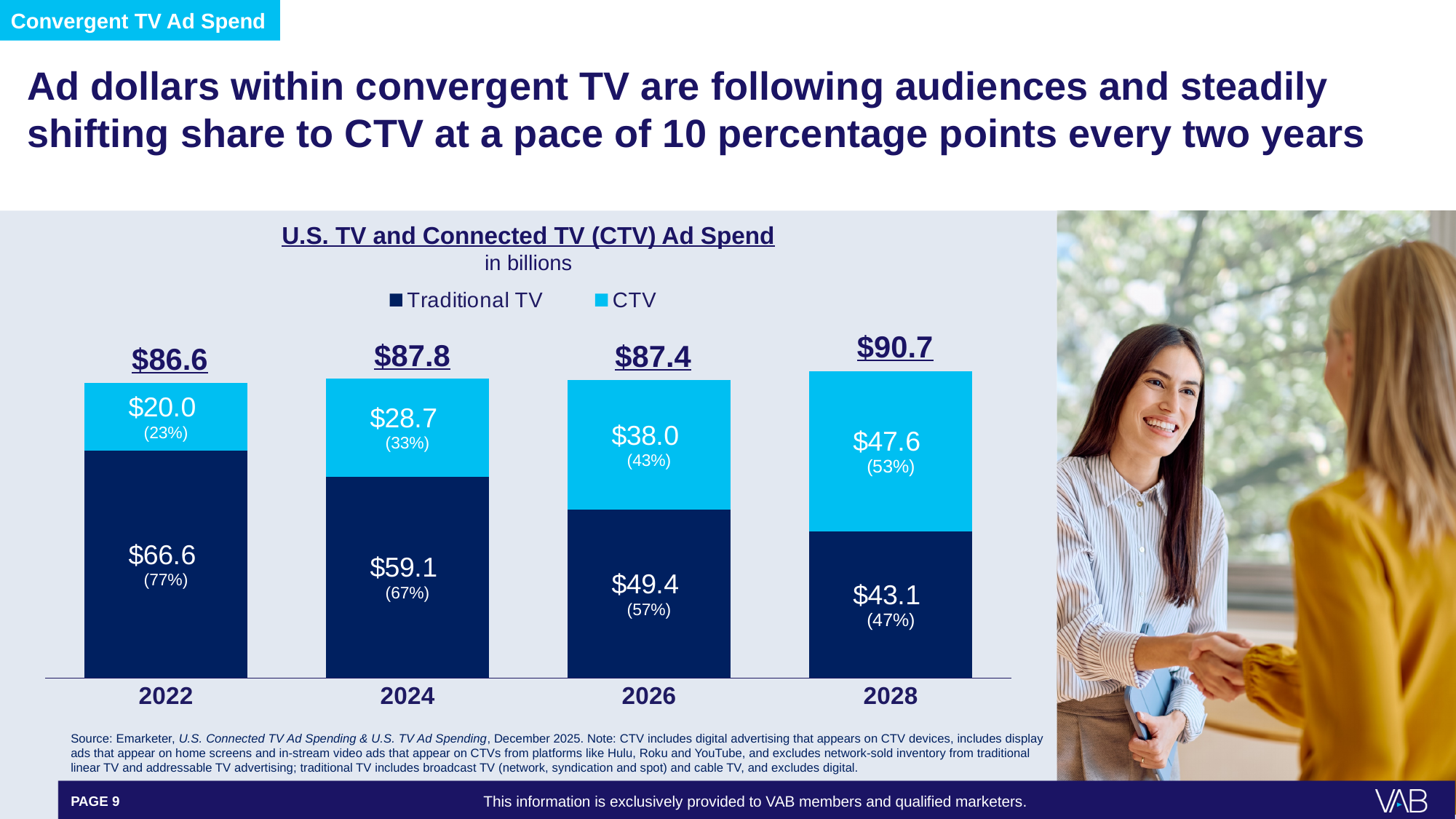
In 2026, which is larger: Traditional TV or CTV ad spend? Traditional TV What kind of chart is this? Stacked bar chart How many series does the legend list? 2 What is the total ad spend shown for 2024? $87.8 What percentage share does CTV hold in 2028? 53% What is the difference between the Traditional TV value in 2022 and the Traditional TV value in 2028? $23.5 What is the Traditional TV ad spend value shown for 2026? $49.4 Which year has the lowest CTV ad spend? 2022 What is the CTV ad spend value shown for 2024? $28.7 Does the CTV ad spend rise or fall from 2022 to 2028? Rise How many years are shown on the x axis? 4 Which year has the highest total ad spend? 2028